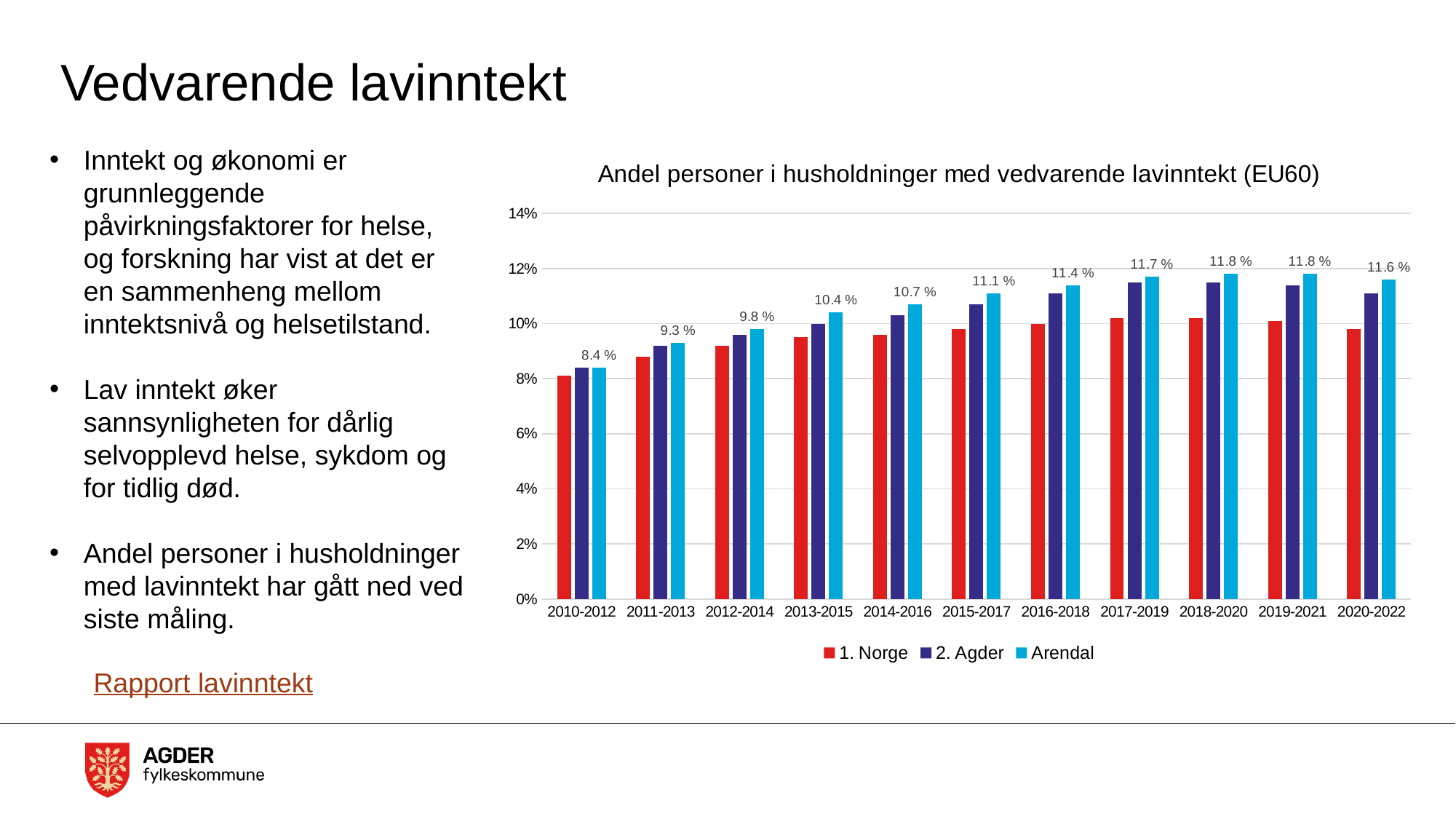
How many periods are shown on the x axis? 11 Do the Arendal values rise or fall from 2010-2012 to 2017-2019? rise What kind of chart is shown? bar chart What is the difference between the Arendal values for 2020-2022 and 2010-2012? 3.2 percentage points What is the value for Arendal in 2010-2012? 8.4 % Is the value for 1. Norge in 2010-2012 greater or less than 10%? less What is the value for Arendal in 2020-2022? 11.6 % Is the value for 2. Agder in 2020-2022 greater or less than 10%? greater What is the value for Arendal in 2015-2017? 11.1 % In which period is the Arendal value lowest? 2010-2012 In 2020-2022, which is larger: the value for 1. Norge or for Arendal? Arendal How many series does the legend list? 3